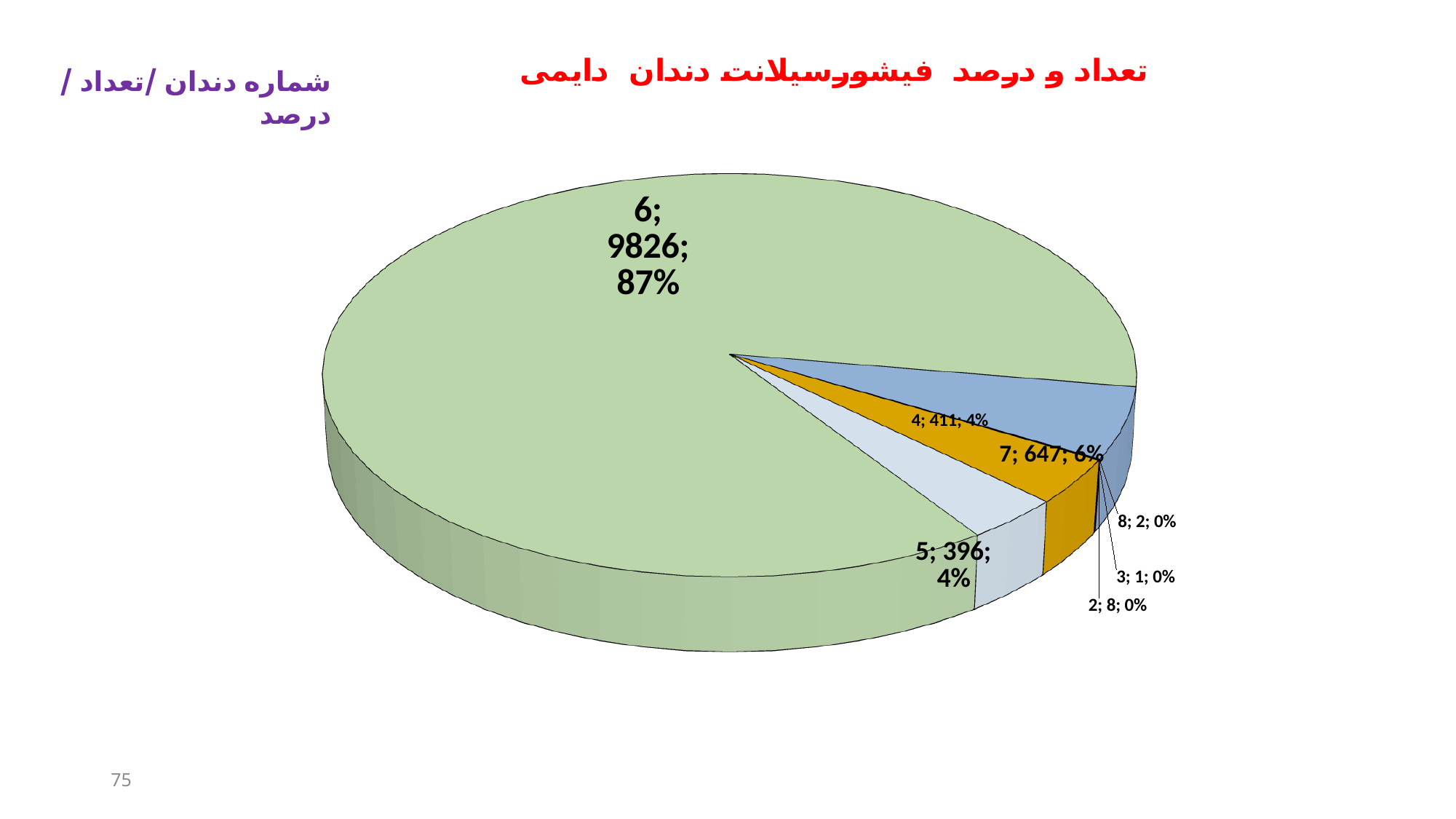
What percentage share does tooth number 7 have? 6% What kind of chart is shown on the slide? pie chart Which has a larger count, tooth number 4 or tooth number 5? tooth number 4 What percentage share does tooth number 6 have in the pie chart? 87% What is the count shown for tooth number 6? 9826 What is the count shown for tooth number 2? 8 What is the difference between the counts for tooth number 7 and tooth number 4? 236 How many slices does the pie chart have? 7 Which tooth number has the largest slice in the pie chart? 6 What is the count shown for tooth number 5? 396 Which tooth number has the smallest count in the pie chart? 3 What is the count shown for tooth number 7? 647